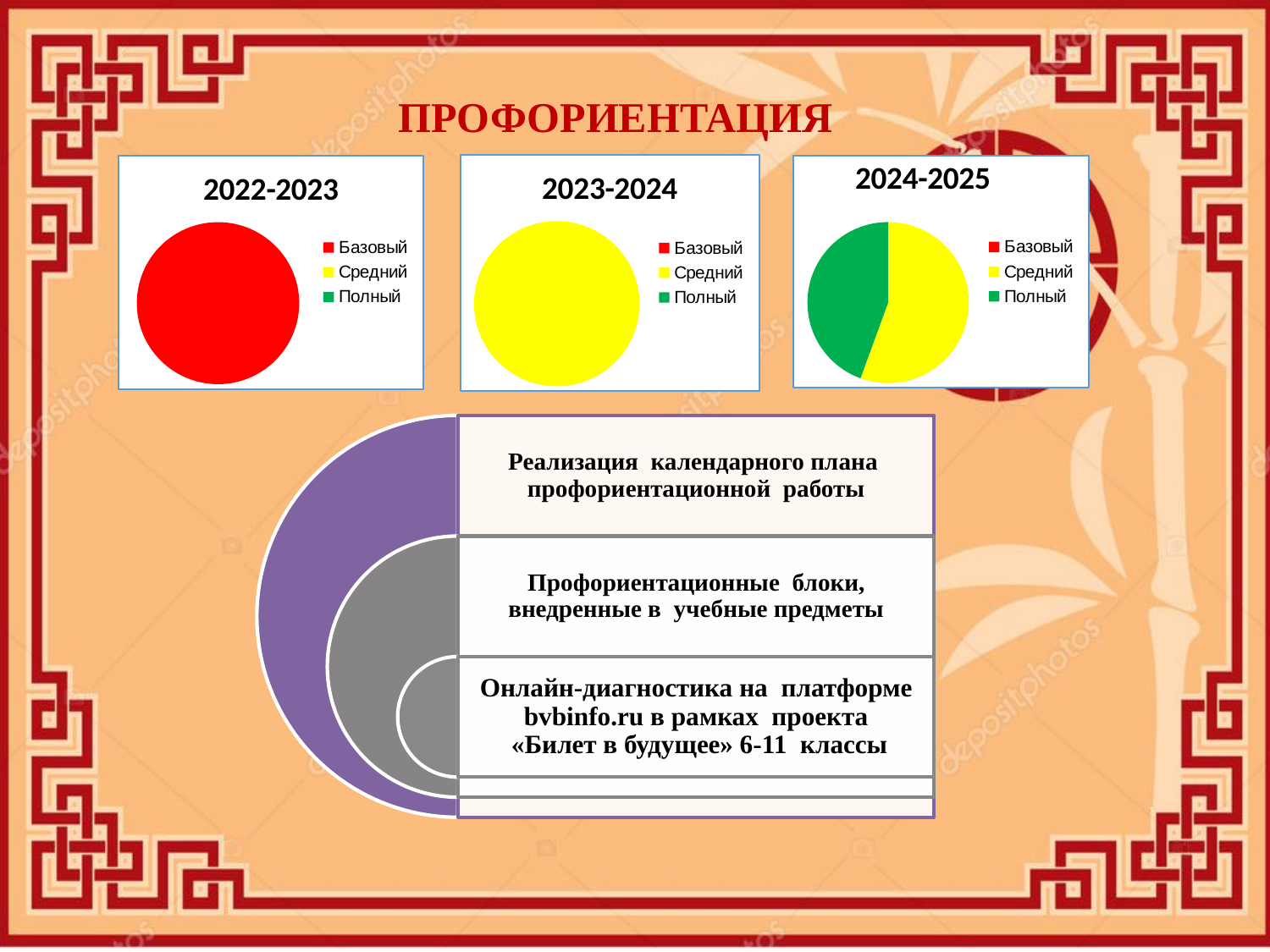
In the 2024-2025 chart, which category has the largest slice? Средний How many slices are visible in the 2024-2025 pie chart? 2 In the 2024-2025 chart, which is larger: the Средний slice or the Полный slice? Средний How many entries does the legend of the 2022-2023 chart list? 3 How many entries does the legend of the 2024-2025 chart list? 3 How many pie charts are shown on the slide? 3 What is the title of the chart on the left? 2022-2023 What kind of chart is the 2022-2023 chart? pie chart What kind of chart is the 2024-2025 chart? pie chart In the 2022-2023 chart, which category fills the entire pie? Базовый In the 2023-2024 chart, which category fills the entire pie? Средний What colour represents Полный in the legend of the 2024-2025 chart? green